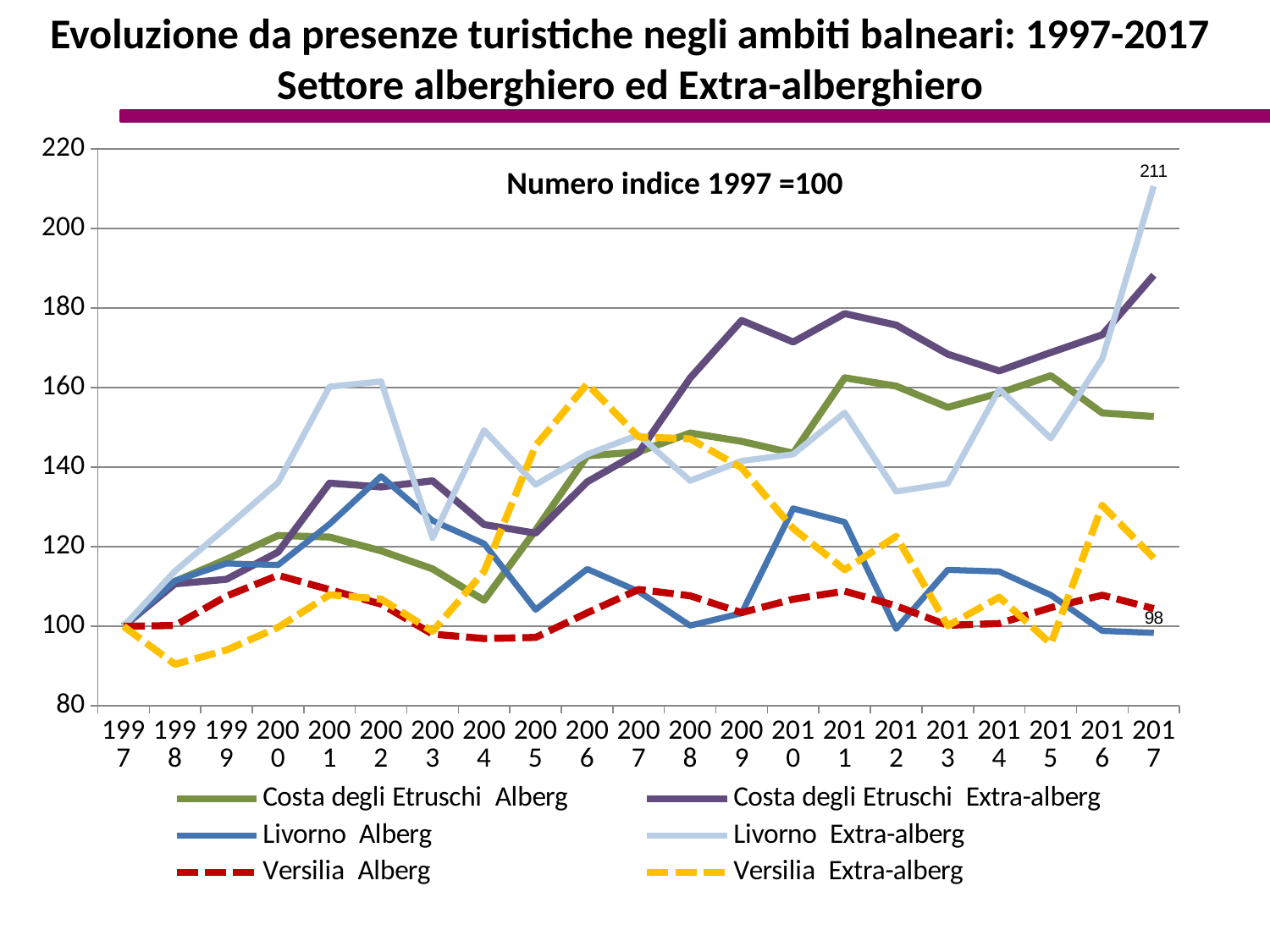
Is the value for Costa degli Etruschi Extra-alberg in 2017 greater or less than 180? greater Is the value for Versilia Extra-alberg in 2006 greater or less than 140? greater What is the difference between Livorno Extra-alberg and Livorno Alberg in 2017? 113 What kind of chart is shown on the slide? line chart Which series has the highest value in 2017? Livorno Extra-alberg What is the value for Livorno Extra-alberg in 2017? 211 How many years are plotted along the x axis? 21 Which series has the lowest value in 2017? Livorno Alberg In 2017, which is larger: Livorno Extra-alberg or Costa degli Etruschi Extra-alberg? Livorno Extra-alberg How many series does the legend list? 6 What is the value for Livorno Alberg in 2017? 98 What base-year note is printed inside the plot area? Numero indice 1997 =100